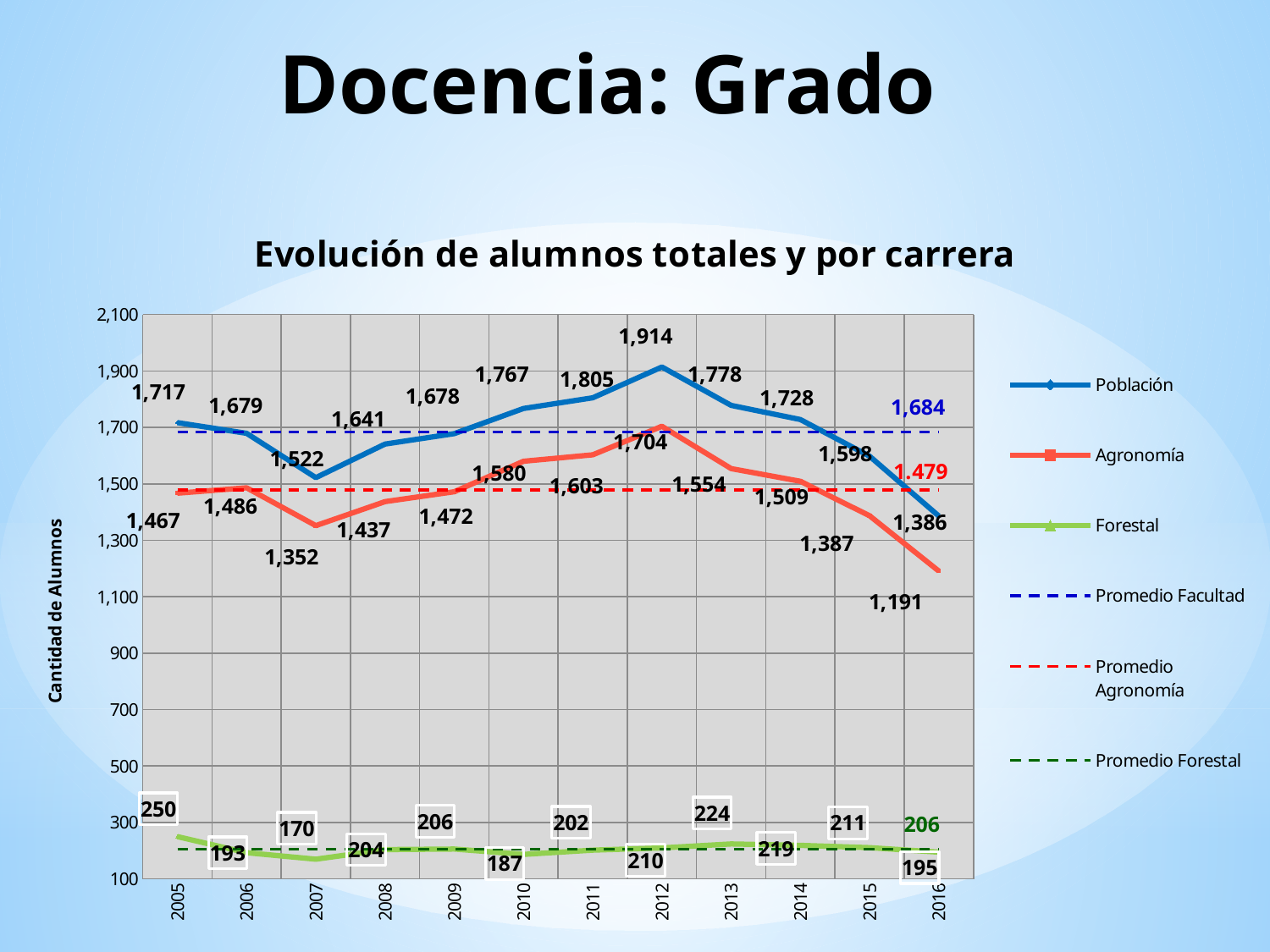
What value is shown for Promedio Agronomía? 1.479 What is the difference between the Población value in 2005 and in 2016? 331 What is the title of the chart? Evolución de alumnos totales y por carrera What is the value of Forestal in 2013? 224 How many years are shown on the x axis? 12 What is the value of Población in 2012? 1,914 In which year is the Agronomía series at its lowest? 2016 Does the Población series rise or fall from 2012 to 2016? Fall Which is larger, the Agronomía value in 2010 or in 2011? 2011 What kind of chart is shown on the slide? Line chart How many series does the legend list? 6 In which year does the Población series reach its highest value? 2012